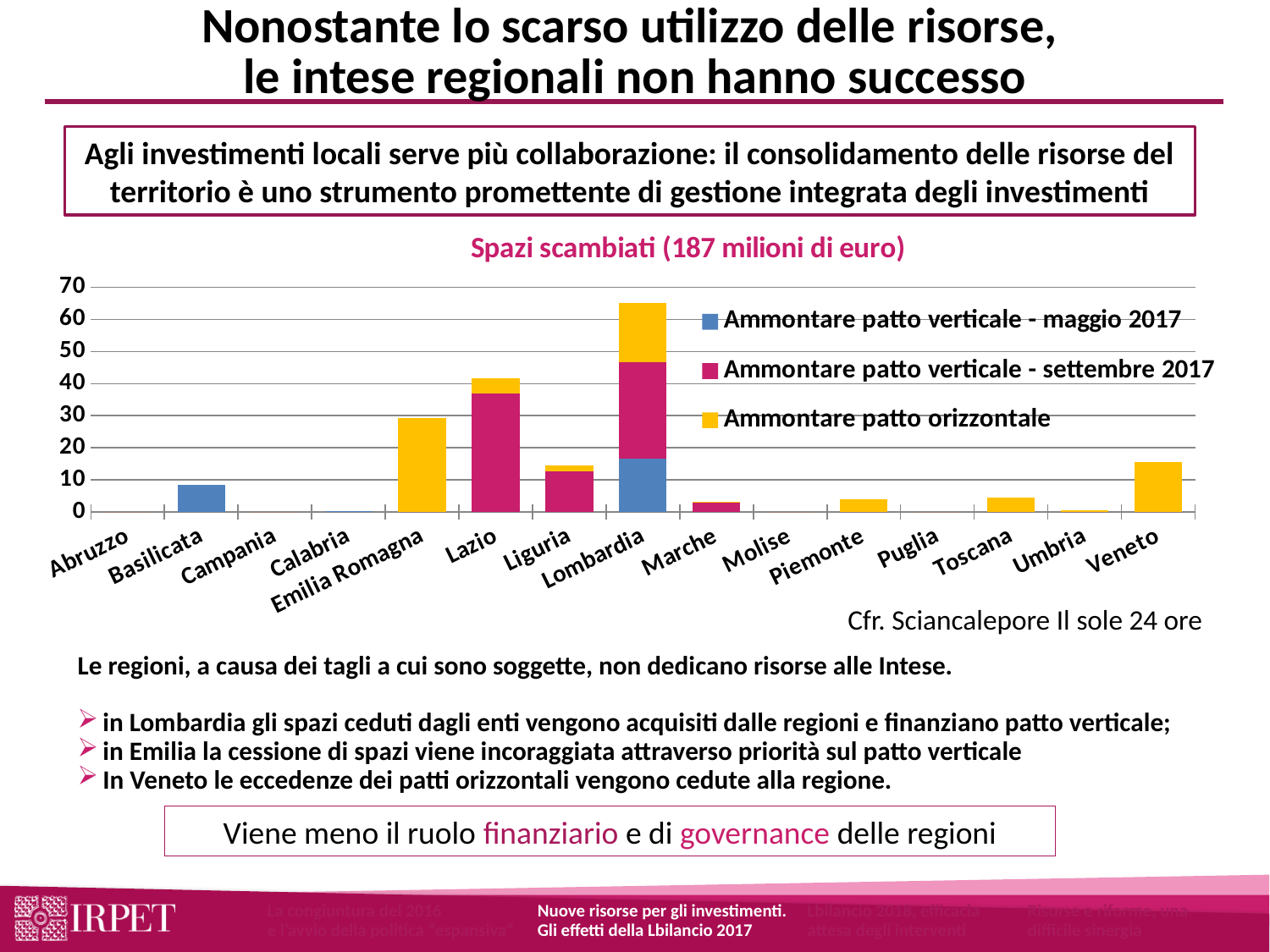
Which region has the highest total bar in the chart? Lombardia Is the total value for Lombardia greater or less than 60? greater Which has a larger total bar, Lazio or Emilia Romagna? Lazio Is the total value for Veneto greater or less than 10? greater How many regions are shown on the x axis of the chart? 15 What type of chart is shown on the slide? Stacked bar chart How many series does the chart legend list? 3 What is the title of the chart? Spazi scambiati (187 milioni di euro) Is the total value for Emilia Romagna greater or less than 20? greater Which series is shown in yellow in the chart? Ammontare patto orizzontale